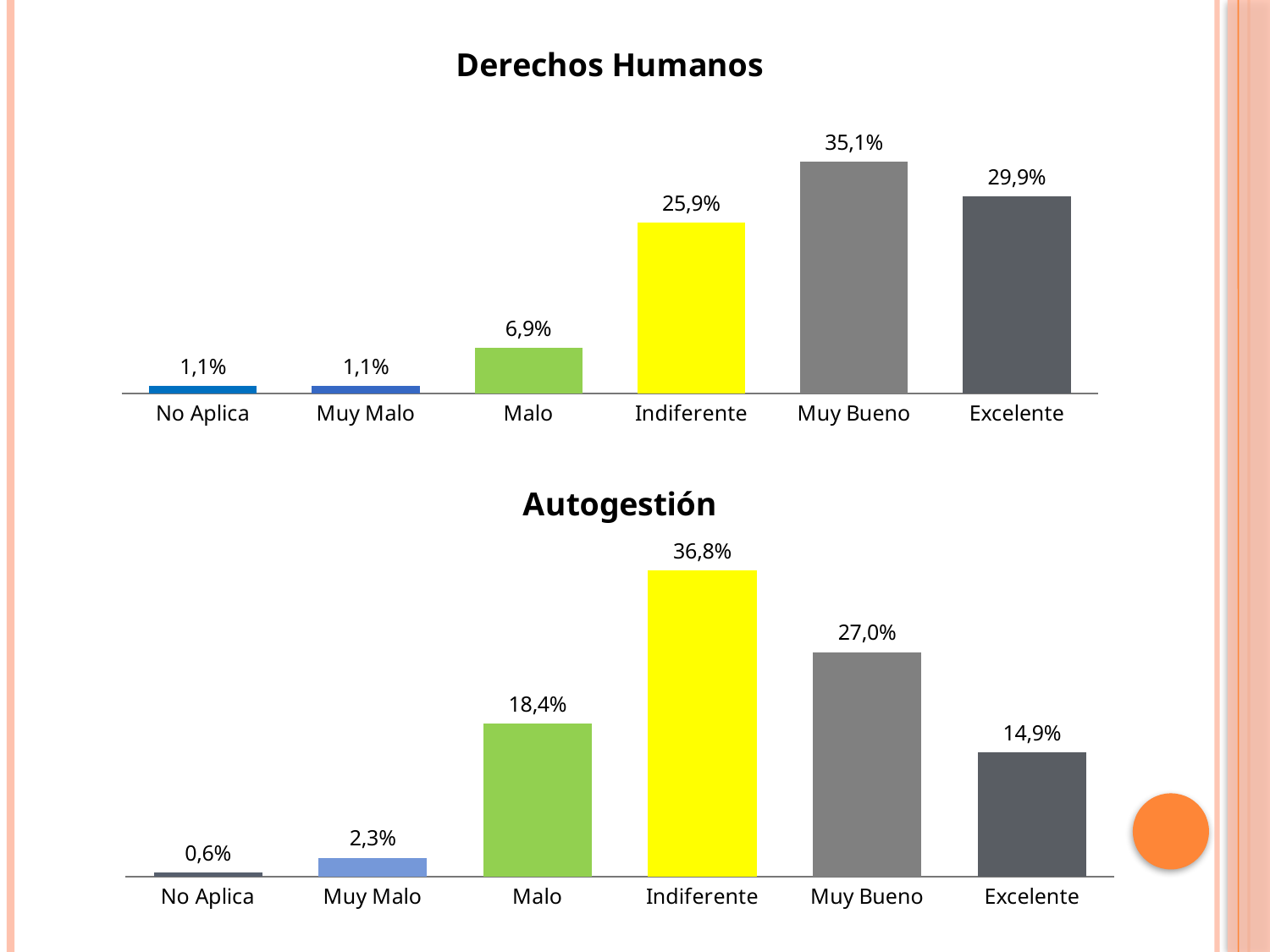
What kind of chart is the Autogestión chart? Bar chart In the Derechos Humanos chart, which category has the highest value? Muy Bueno In the Derechos Humanos chart, what is the difference between Muy Bueno and Excelente? 5,2% In the Autogestión chart, what is the value for Malo? 18,4% In the Derechos Humanos chart, what is the value for Muy Bueno? 35,1% In the Derechos Humanos chart, what is the value for Indiferente? 25,9% In the Autogestión chart, what is the value for Excelente? 14,9% How many categories does the Derechos Humanos chart show? 6 In the Autogestión chart, what is the difference between Indiferente and Muy Bueno? 9,8% In the Autogestión chart, which category has the lowest value? No Aplica In the Autogestión chart, which is larger, Malo or Excelente? Malo In the Autogestión chart, which category has the highest value? Indiferente